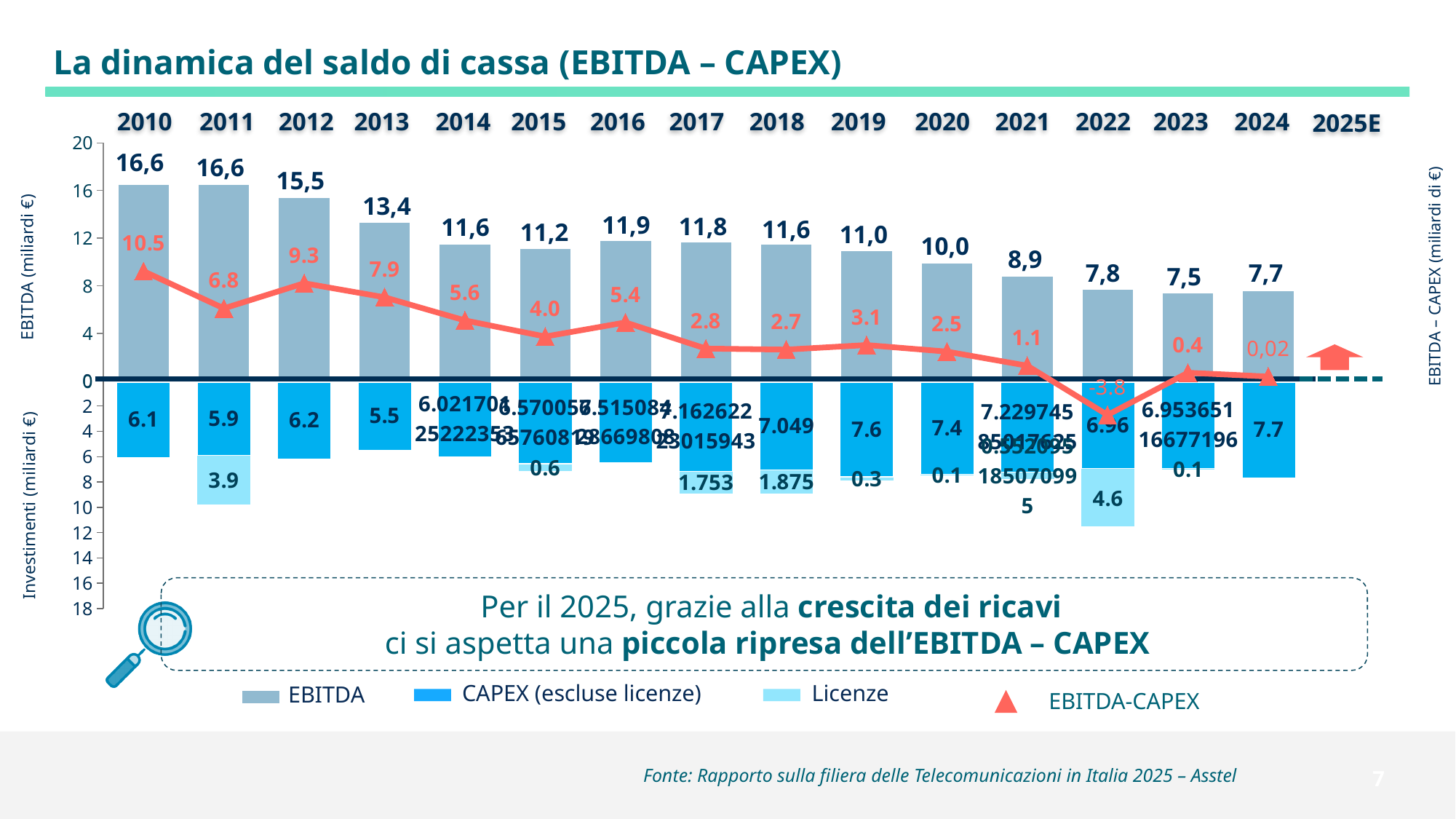
What is the difference between EBITDA in 2010 and EBITDA in 2024? 8,9 How many series does the legend list? 4 In which year is the EBITDA – CAPEX value lowest? 2022 What is the EBITDA value for 2013? 13,4 What is the CAPEX (escluse licenze) value for 2018? 7.049 What is the EBITDA – CAPEX value for 2022? -3.8 Does EBITDA rise or fall from 2010 to 2024? fall In which year is the EBITDA – CAPEX value highest? 2010 Which year has the larger CAPEX (escluse licenze) value, 2010 or 2012? 2012 In which year is EBITDA lowest? 2023 What kind of chart is shown on the slide? bar and line chart What is the Licenze value for 2022? 4.6